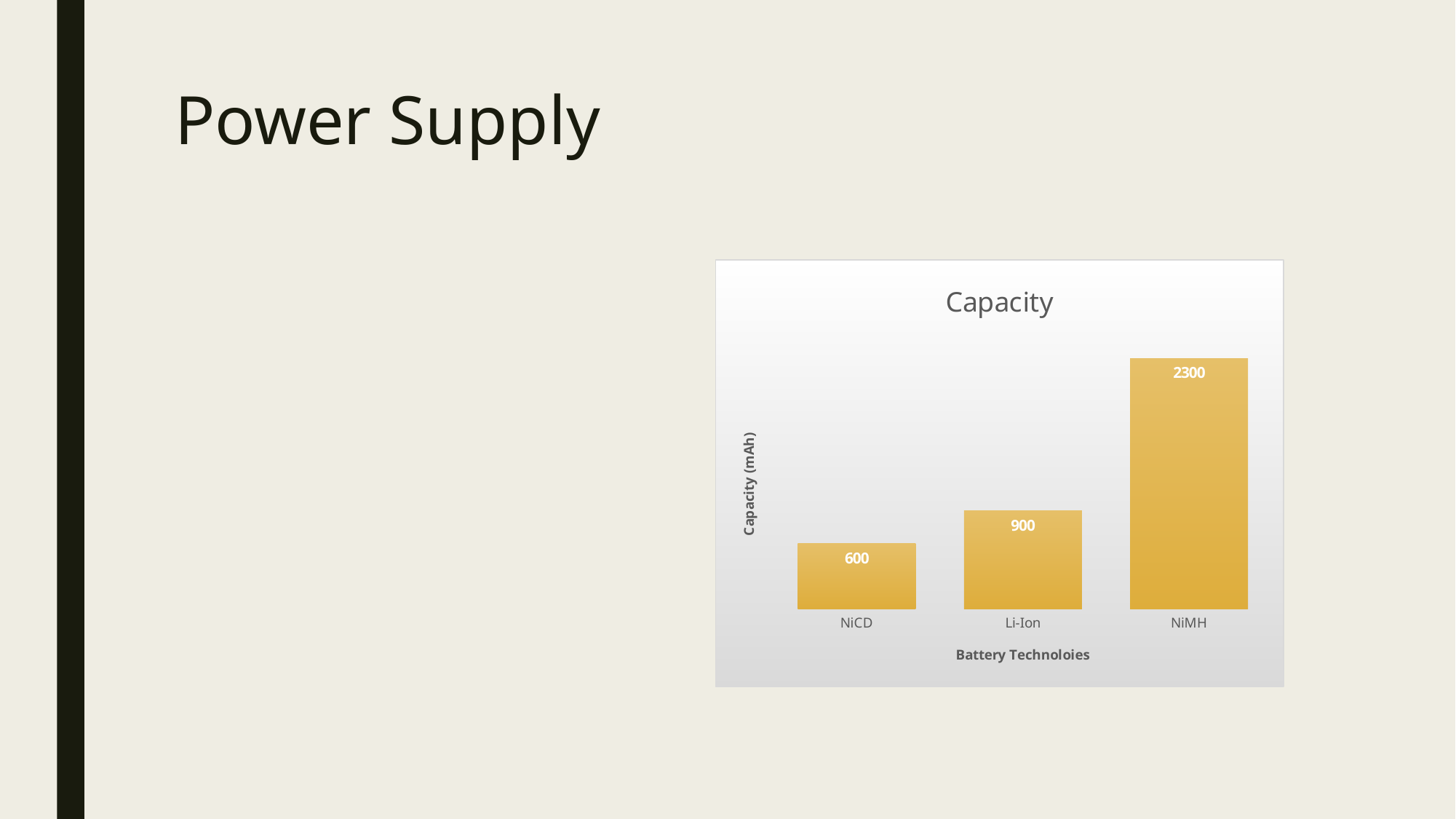
What kind of chart is shown on the slide? Bar chart What is the difference in capacity between NiMH and Li-Ion? 1400 What is the capacity value shown for Li-Ion? 900 What is the title of the chart? Capacity Which battery technology has the highest capacity? NiMH Do the capacity values rise or fall from left to right across the x axis? Rise What is the capacity value shown for NiCD? 600 Which battery technology has the lowest capacity? NiCD How many battery technologies are shown in the chart? 3 Which has a larger capacity, NiCD or Li-Ion? Li-Ion What is the difference in capacity between Li-Ion and NiCD? 300 What is the capacity value shown for NiMH? 2300